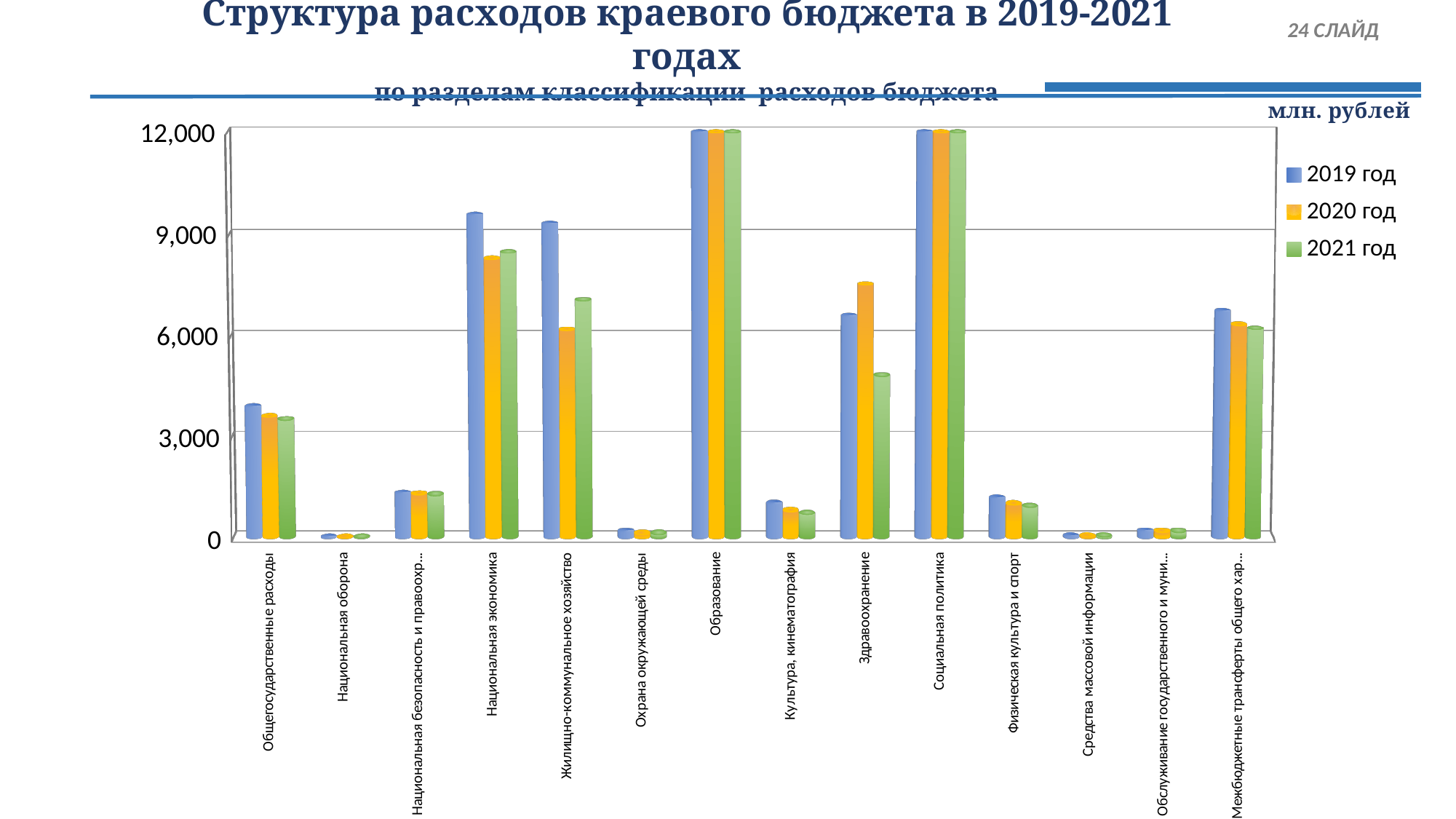
Is the 2019 value for Национальная экономика greater or less than 9,000? greater For Здравоохранение, which year has the larger value: 2020 or 2021? 2020 In what units are the values on the chart expressed, according to the label above the legend? млн. рублей How many series does the legend list? 3 Which years are listed in the legend? 2019 год, 2020 год, 2021 год Is the 2020 value for Национальная экономика greater or less than 9,000? less Is the 2021 value for Здравоохранение greater or less than 6,000? less How many expenditure categories are shown along the x axis? 14 For Жилищно-коммунальное хозяйство, which year has the larger value: 2019 or 2021? 2019 What kind of chart is shown on the slide? Bar chart